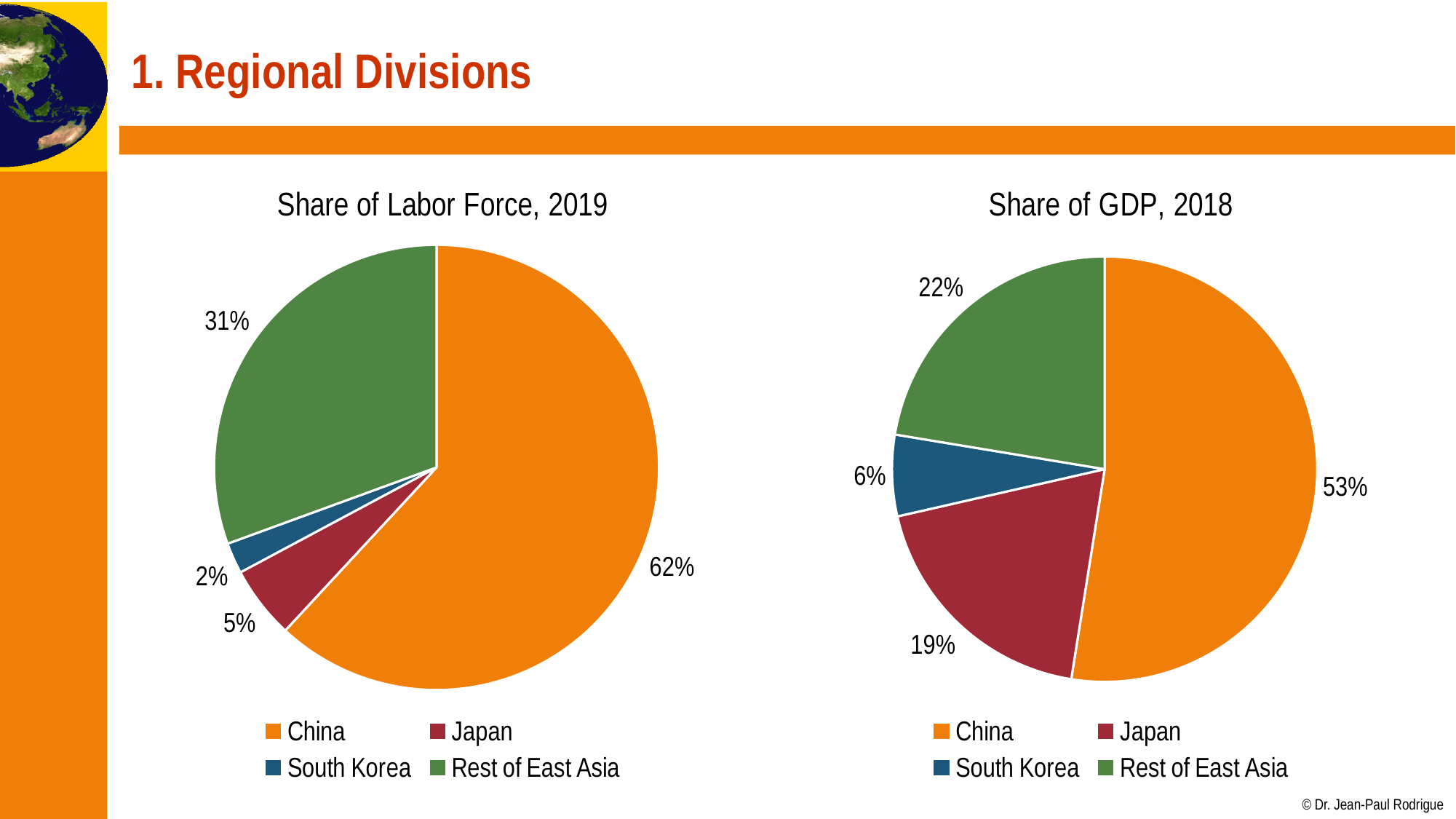
What kind of chart is 'Share of Labor Force, 2019'? Pie chart How many categories does the 'Share of GDP, 2018' chart show? 4 In the 'Share of Labor Force, 2019' chart, what is China's share? 62% Which colour represents Rest of East Asia in the legend of the 'Share of GDP, 2018' chart? Green In the 'Share of Labor Force, 2019' chart, what is the combined share of Japan and South Korea? 7% In the 'Share of GDP, 2018' chart, what is the difference between China's share and Rest of East Asia's share? 31% In the 'Share of Labor Force, 2019' chart, which category has the smallest share? South Korea In the 'Share of GDP, 2018' chart, what is South Korea's share? 6% In the 'Share of Labor Force, 2019' chart, which is larger: Japan's share or South Korea's share? Japan In the 'Share of GDP, 2018' chart, what is Japan's share? 19% In the 'Share of Labor Force, 2019' chart, what is the share for Rest of East Asia? 31% In the 'Share of GDP, 2018' chart, which category has the largest share? China